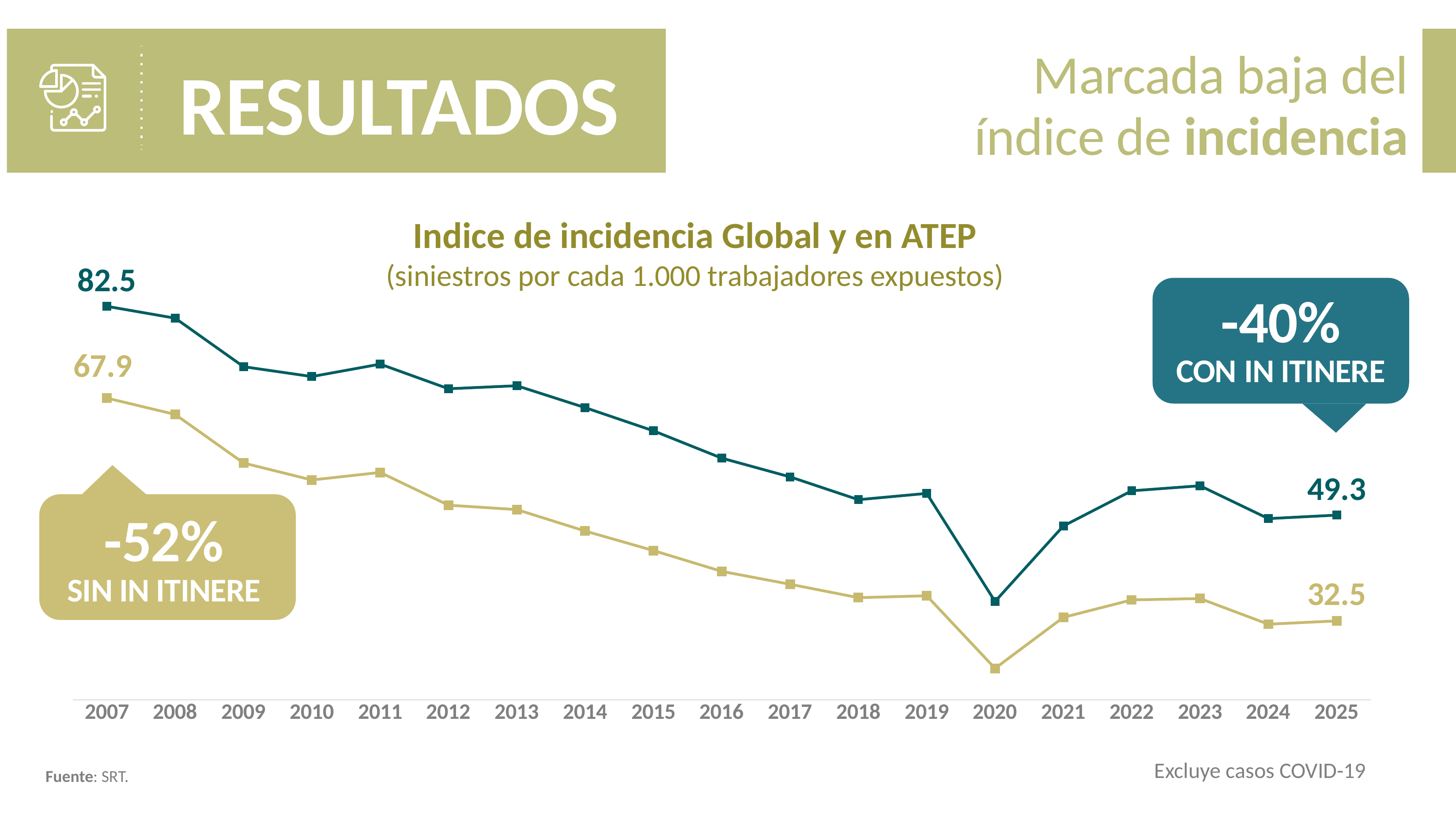
What is the value of the dark teal line (con in itinere) in 2025? 49.3 Do the values generally rise or fall from 2007 to 2025? fall What is the value of the dark teal line (con in itinere) in 2007? 82.5 What is the value of the olive line (sin in itinere) in 2025? 32.5 How many years are shown on the x axis of the chart? 19 What is the title of the chart? Indice de incidencia Global y en ATEP What kind of chart is shown on the slide? line chart What is the difference between the two lines in 2007? 14.6 By how much did the dark teal line (con in itinere) fall from 2007 to 2025? 33.2 By how much did the olive line (sin in itinere) fall from 2007 to 2025? 35.4 In which year does the dark teal line reach its lowest point? 2020 What is the value of the olive line (sin in itinere) in 2007? 67.9